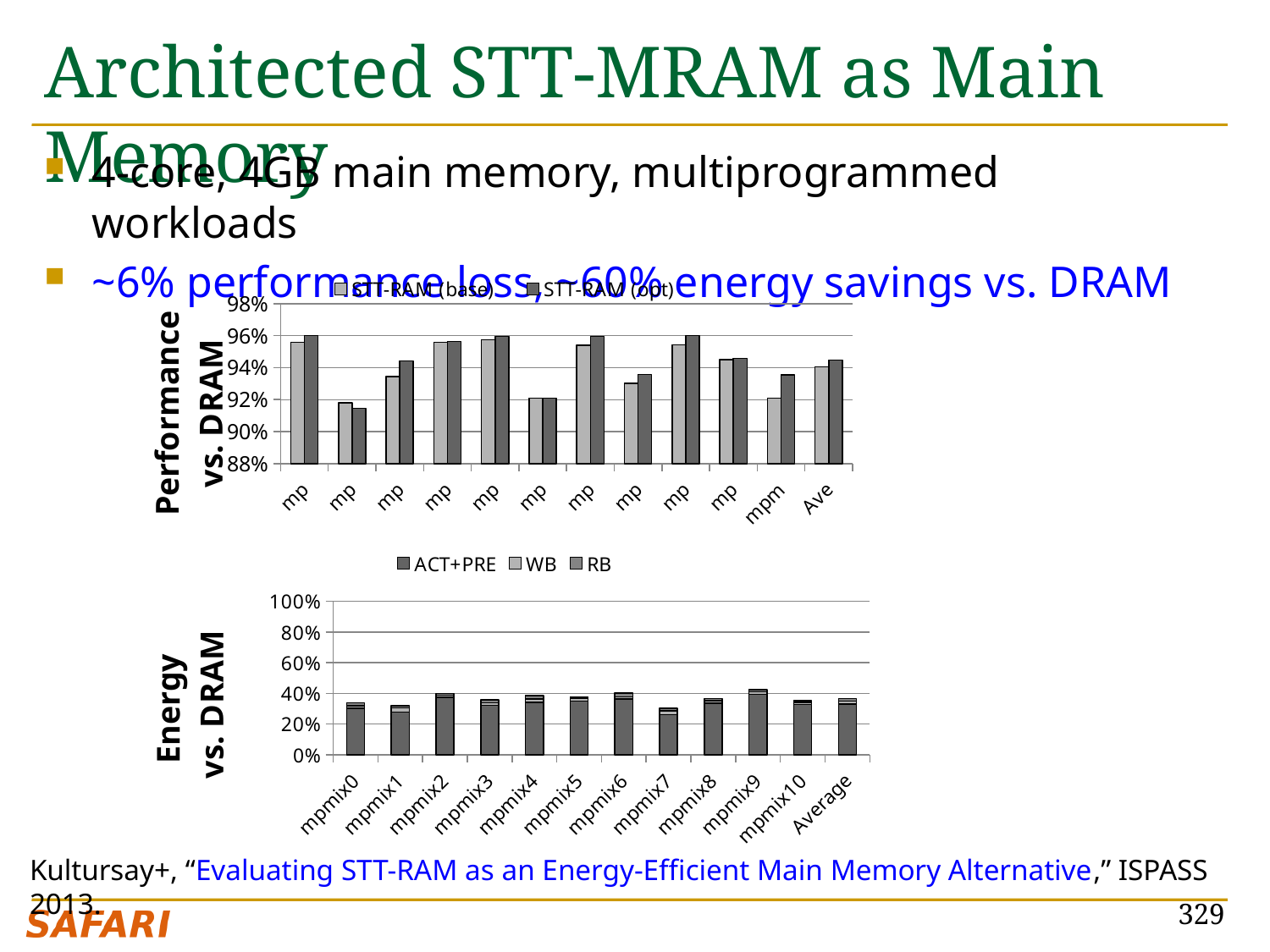
In the bottom chart (Energy vs. DRAM), is the total for mpmix7 greater or less than 40%? less In the top chart (Performance vs. DRAM), is the STT-RAM (opt) value for mpm greater or less than 92%? greater How many series does the legend of the bottom chart (Energy vs. DRAM) list? 3 In the top chart (Performance vs. DRAM), is the STT-RAM (opt) value for Ave greater or less than 92%? greater How many series does the legend of the top chart (Performance vs. DRAM) list? 2 In the top chart (Performance vs. DRAM), what are the two series named in the legend? STT-RAM (base) and STT-RAM (opt) What kind of chart is the top chart (Performance vs. DRAM)? bar chart In the bottom chart (Energy vs. DRAM), which category has the highest total energy? mpmix9 What kind of chart is the bottom chart (Energy vs. DRAM)? bar chart In the bottom chart (Energy vs. DRAM), how many categories are plotted along the x axis? 12 In the top chart (Performance vs. DRAM), how many categories are plotted along the x axis? 12 In the bottom chart (Energy vs. DRAM), which has the larger total energy, mpmix9 or mpmix7? mpmix9